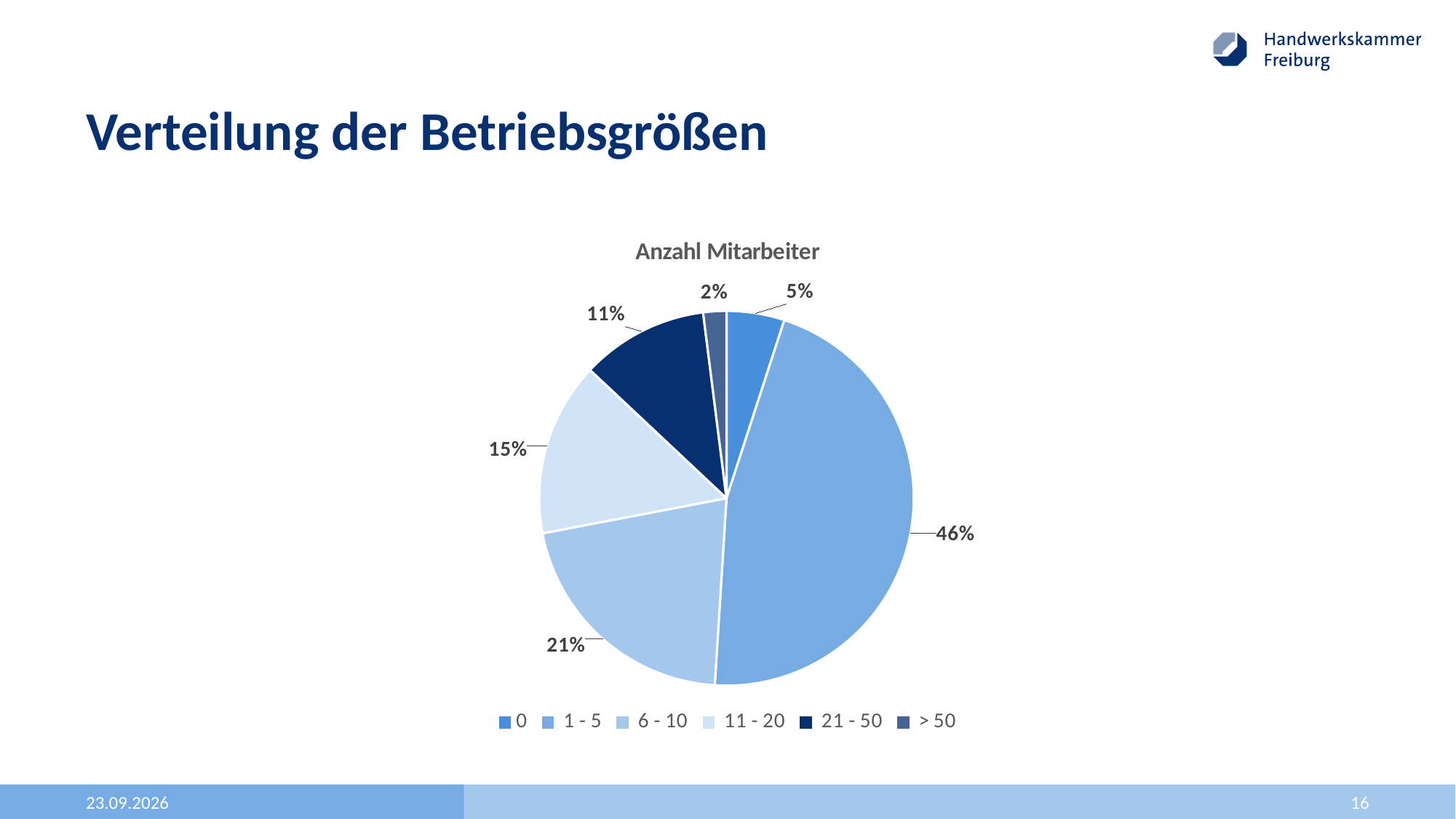
What share of the pie does the '1 - 5' category have? 46% What is the difference in percentage points between the '6 - 10' and '11 - 20' shares? 6 Which category has the smallest share of the pie? > 50 What share of the pie does the '6 - 10' category have? 21% What share of the pie does the '21 - 50' category have? 11% What type of chart is shown on the slide? pie chart Which category has the largest share of the pie? 1 - 5 What is the title of the chart? Anzahl Mitarbeiter How many categories does the legend list? 6